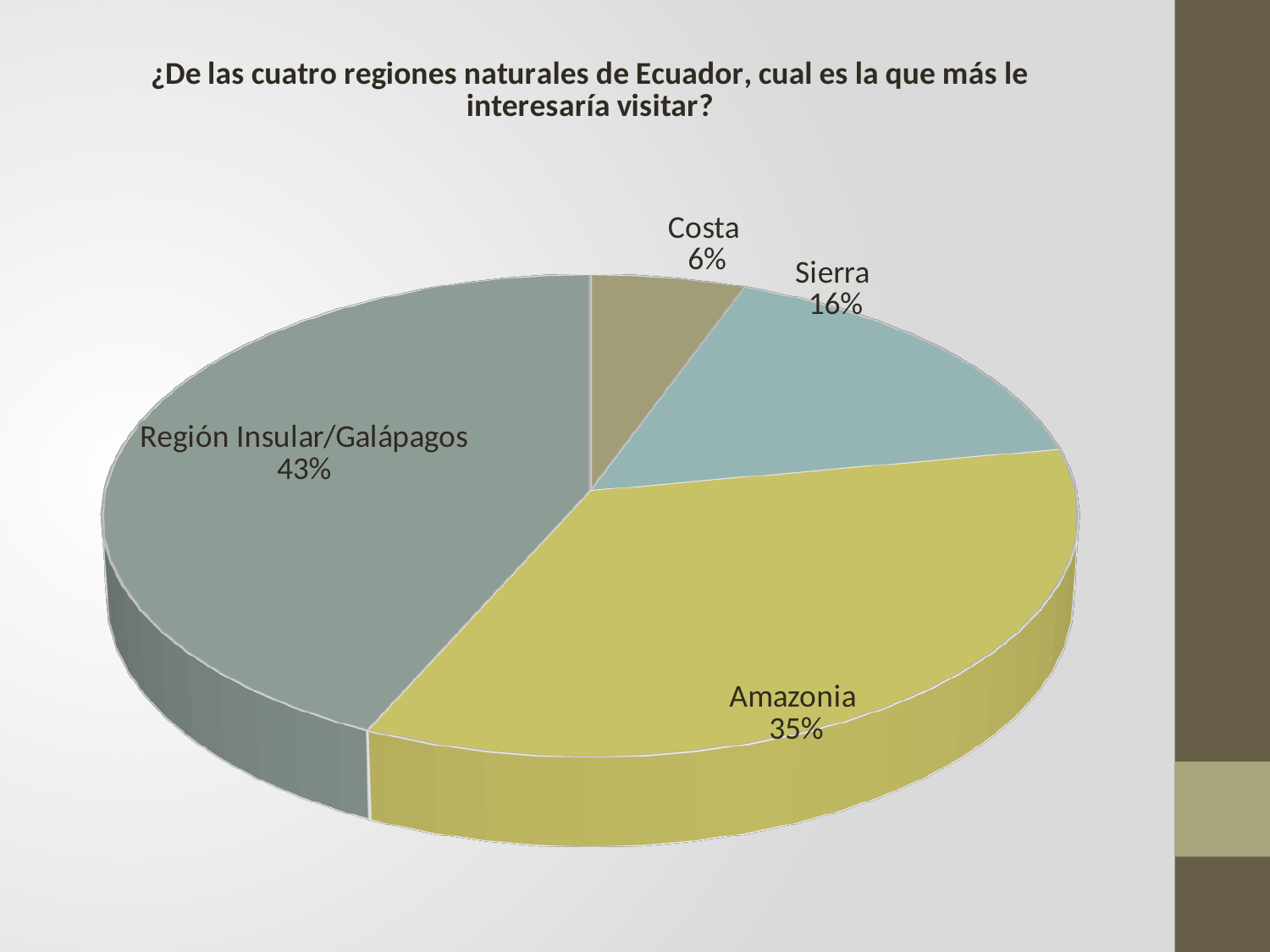
What share of the pie does Región Insular/Galápagos have? 43% What share of the pie does Costa have? 6% What is the difference in percentage points between Sierra and Costa? 10 What is the title of the chart? ¿De las cuatro regiones naturales de Ecuador, cual es la que más le interesaría visitar? How many slices does the pie chart have? 4 What share of the pie does Sierra have? 16% Which region has the smallest slice of the pie? Costa Which is larger, the share for Sierra or the share for Costa? Sierra What is the difference in percentage points between Región Insular/Galápagos and Amazonia? 8 Which region has the largest slice of the pie? Región Insular/Galápagos What kind of chart is shown on the slide? pie chart